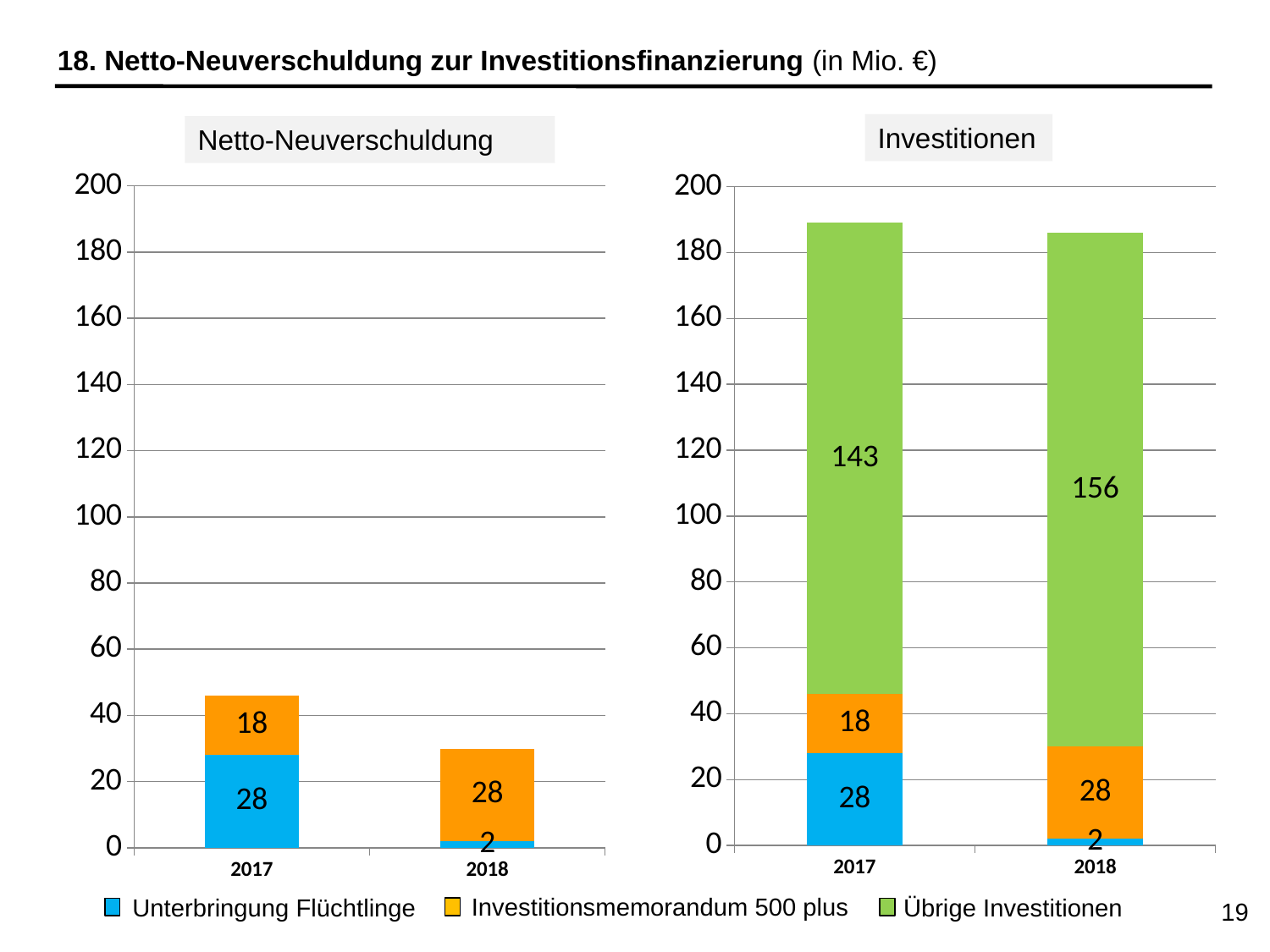
In the Netto-Neuverschuldung chart, which year has the larger value for Unterbringung Flüchtlinge, 2017 or 2018? 2017 Which legend entry is shown in green? Übrige Investitionen In the Netto-Neuverschuldung chart, what is the total of the stacked bar for 2017? 46 How many series does the legend list? 3 What kind of chart is the Investitionen chart? Stacked bar chart In the Netto-Neuverschuldung chart, what is the value for Investitionsmemorandum 500 plus in 2018? 28 In the Investitionen chart, is the total for 2017 greater or less than 180? greater In the Investitionen chart, what is the total of the stacked bar for 2018? 186 In the Investitionen chart, what is the value for Übrige Investitionen in 2017? 143 In the Netto-Neuverschuldung chart, what is the value for Unterbringung Flüchtlinge in 2017? 28 In the Investitionen chart, what is the value for Übrige Investitionen in 2018? 156 In the Investitionen chart, what is the difference between Übrige Investitionen in 2018 and in 2017? 13